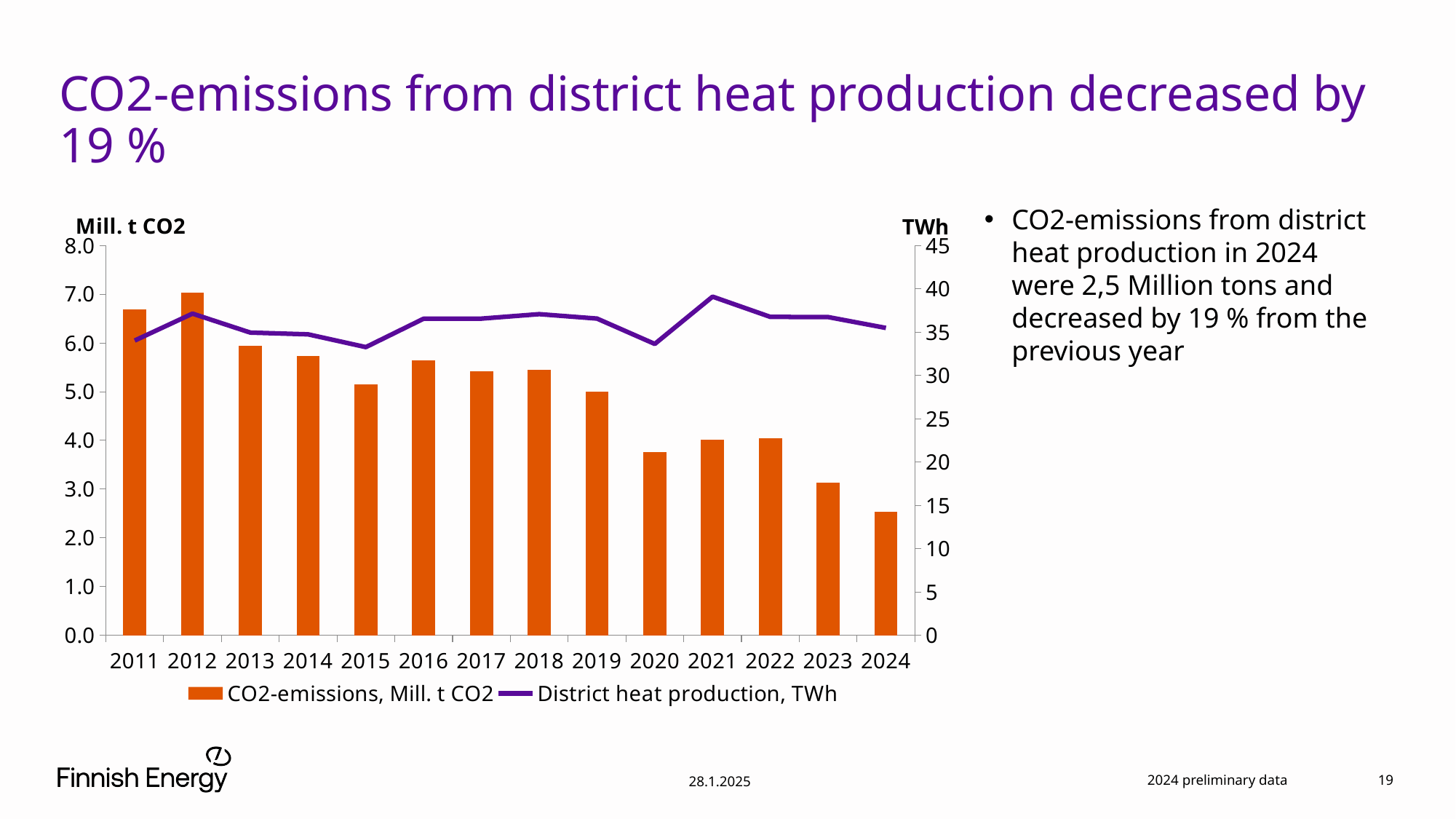
Do the CO2-emissions bars generally rise or fall from 2011 to 2024? fall What unit is labelled on the right-hand axis? TWh In which year is the CO2-emissions bar the lowest? 2024 Is the CO2-emissions value for 2024 greater or less than 3.0? less In which year does the District heat production line reach its highest point? 2021 How many years are shown on the x axis? 14 How many series does the legend list? 2 What kind of chart is shown on the slide? A combined bar and line chart In which year is the CO2-emissions bar the highest? 2012 Is the CO2-emissions value for 2011 greater or less than 6.0? greater Which year has the larger CO2-emissions bar, 2018 or 2019? 2018 Is the District heat production value for 2021 greater or less than 35 TWh? greater